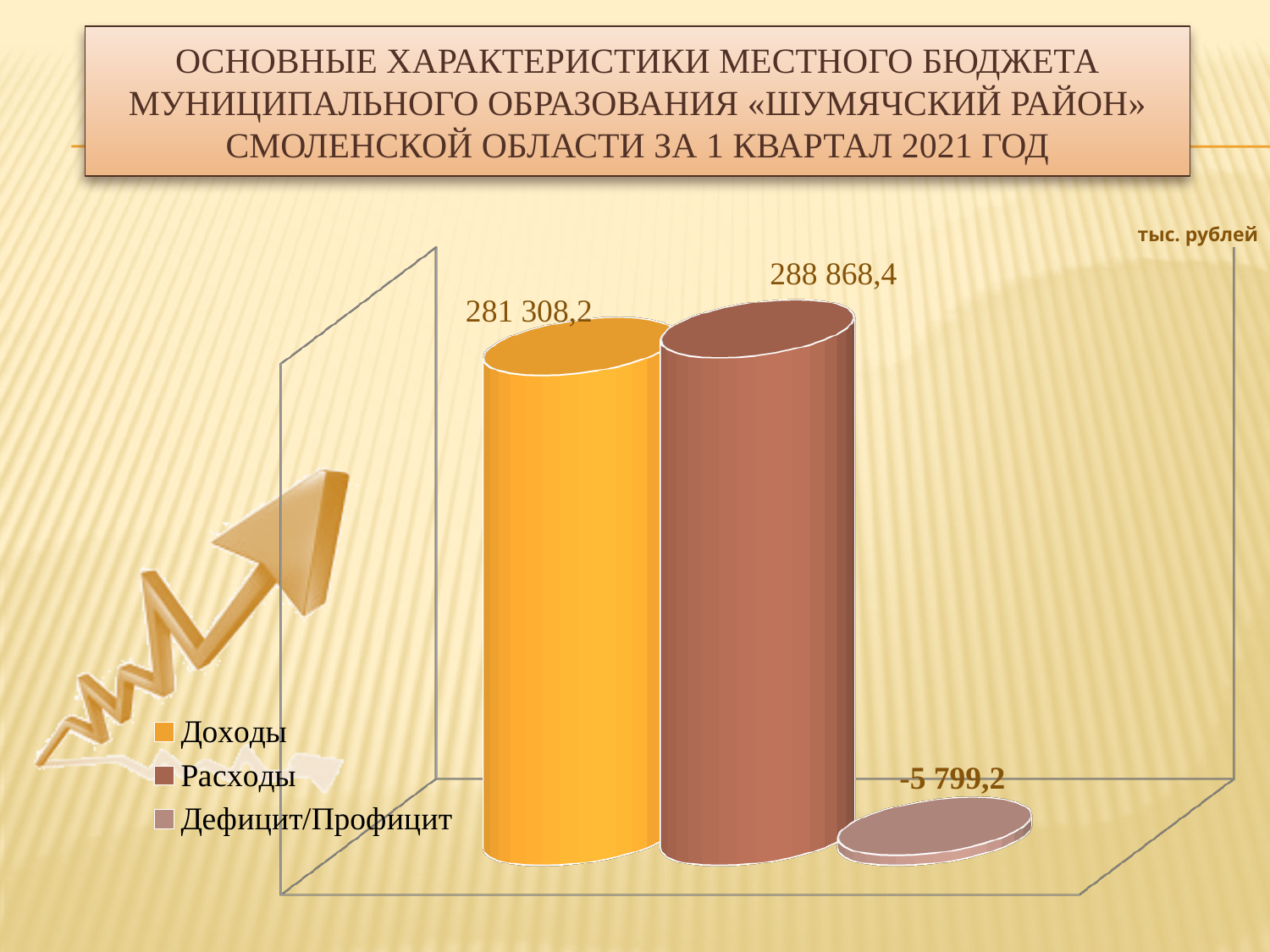
What is the difference between Расходы and Доходы? 7 560,2 Which is larger, Доходы or Расходы? Расходы What kind of chart is shown on the slide? Bar chart What is the value for Доходы? 281 308,2 Which series has the highest value? Расходы What colour is the bar for Доходы? Orange/yellow What is the value for Дефицит/Профицит? -5 799,2 What is the value for Расходы? 288 868,4 What unit of measurement is indicated for the chart values? тыс. рублей How many series does the legend list? 3 How many bars are plotted on the chart? 3 Which series has the lowest value? Дефицит/Профицит